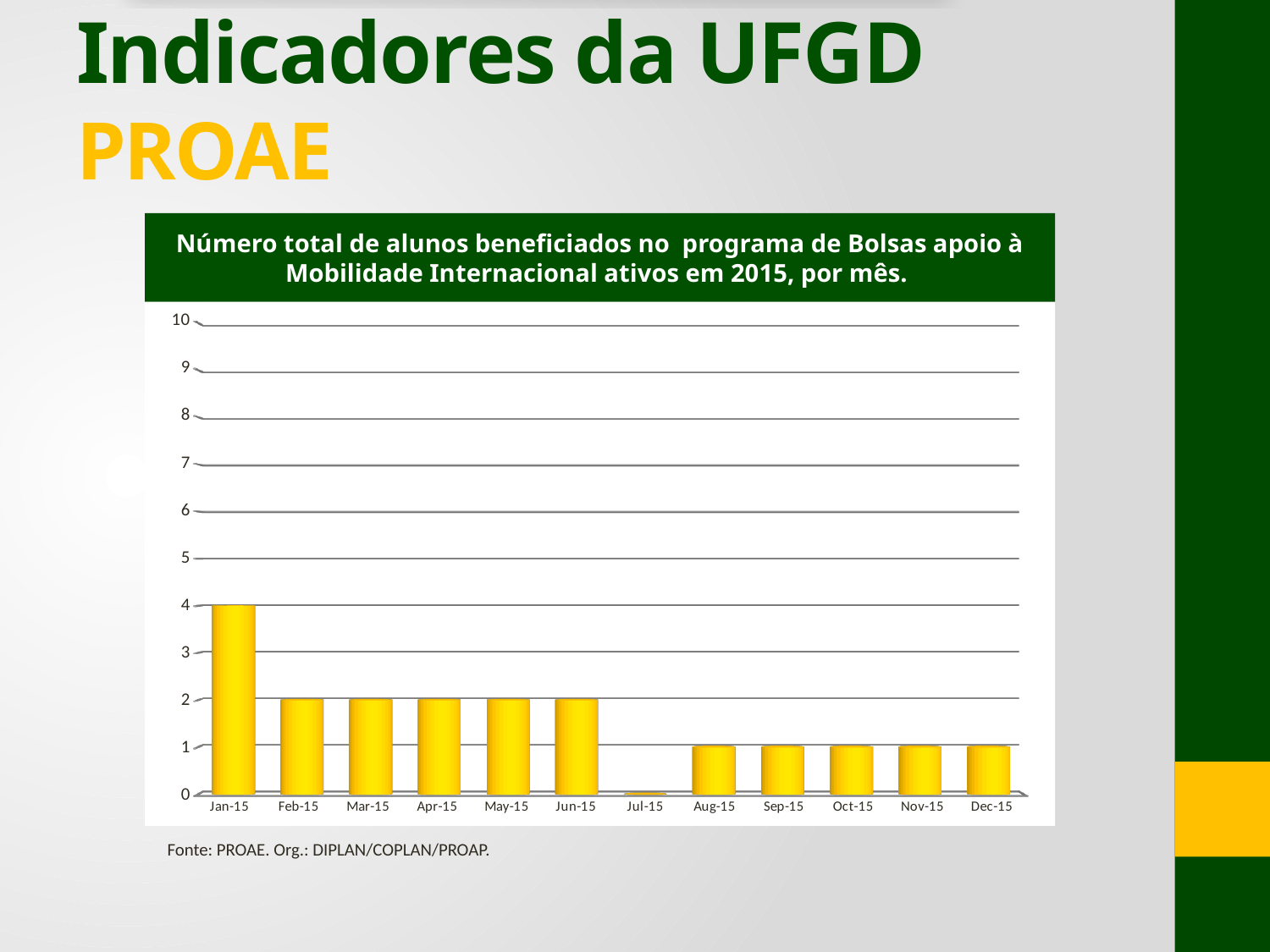
What is the title of the chart? Número total de alunos beneficiados no programa de Bolsas apoio à Mobilidade Internacional ativos em 2015, por mês. What is the value for Oct-15 in the chart? 1 What is the difference between the values for Jan-15 and Feb-15? 2 Is the value for Jan-15 greater or less than 3? greater How many months are plotted on the x axis of the chart? 12 What kind of chart is shown on the slide? bar chart What is the value for Jul-15 in the chart? 0 What is the value for Mar-15 in the chart? 2 What is the value for Jan-15 in the chart? 4 Which month has the highest number of beneficiaries in the chart? Jan-15 Which month has the lowest number of beneficiaries in the chart? Jul-15 Which is larger, the value for Jun-15 or the value for Aug-15? Jun-15